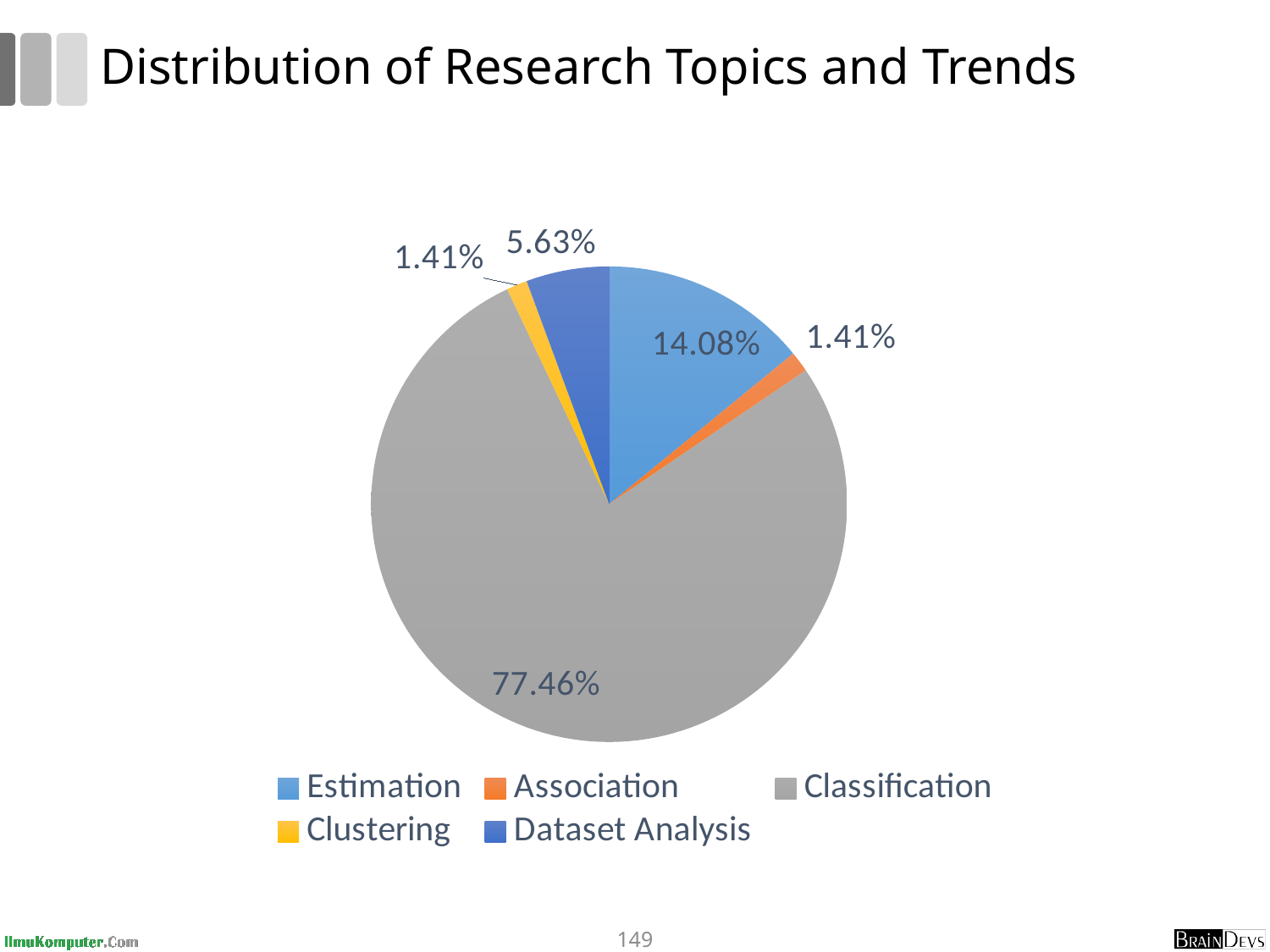
What share of the pie does Dataset Analysis have? 5.63% What is the title of the slide containing the chart? Distribution of Research Topics and Trends What kind of chart is shown on the slide? pie chart Which research topic has the largest share of the pie? Classification What is the difference between the shares for Estimation and Dataset Analysis? 8.45% What share of the pie does Association have? 1.41% What share of the pie does Clustering have? 1.41% Which is larger, the share for Estimation or the share for Dataset Analysis? Estimation What is the difference between the shares for Classification and Estimation? 63.38% What share of the pie does Estimation have? 14.08% What share of the pie does Classification have? 77.46% How many categories does the legend list? 5